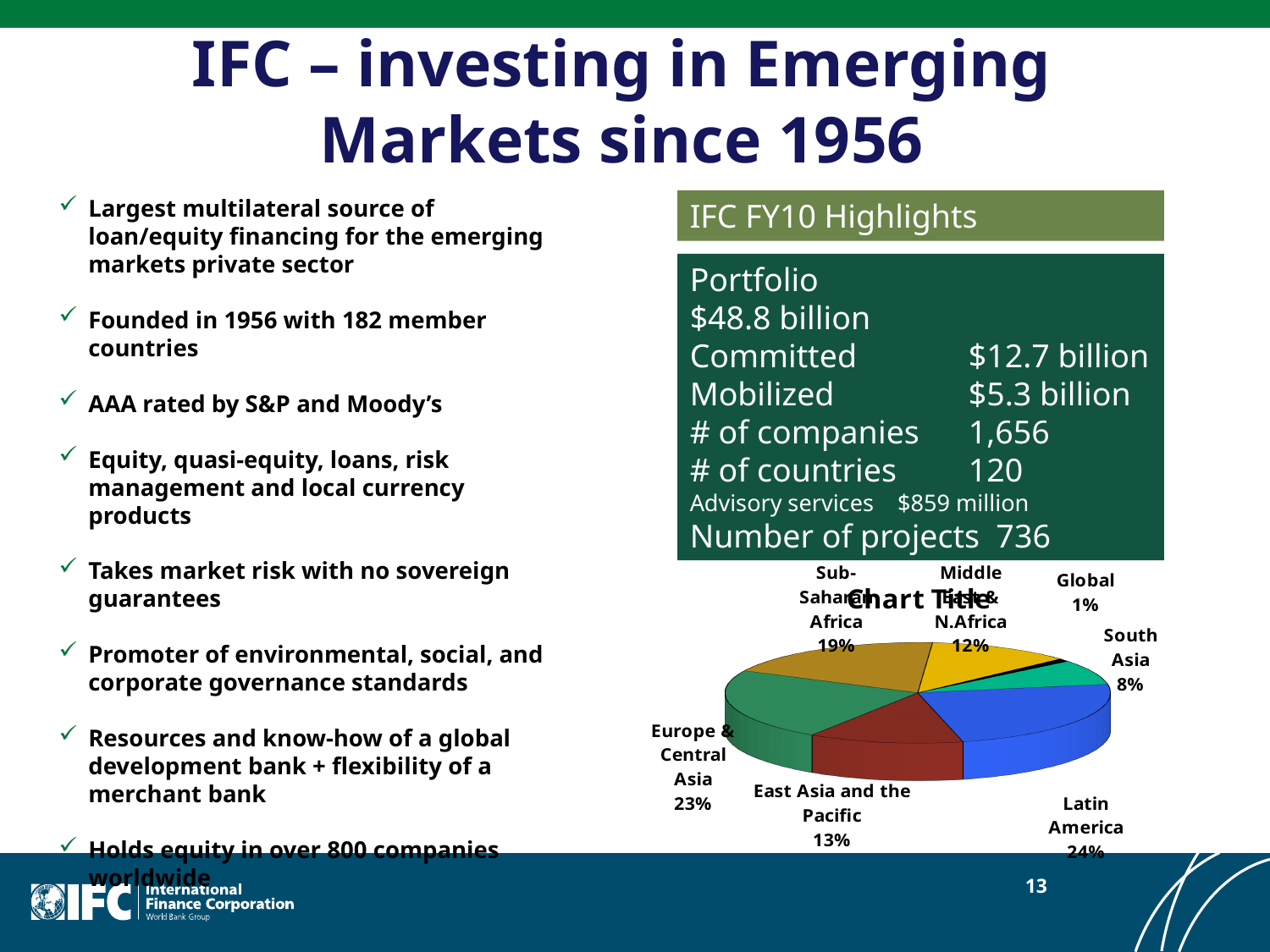
Which has a larger share in the pie chart, East Asia and the Pacific or Middle East & N.Africa? East Asia and the Pacific How many slices does the pie chart have? 7 What share of the pie chart does Middle East & N.Africa represent? 12% What is the title shown on the pie chart? Chart Title Which region has the largest share in the pie chart? Latin America What is the difference in percentage points between Sub-Saharan Africa and South Asia in the pie chart? 11 What type of chart is shown on the slide? pie chart What share of the pie chart does Sub-Saharan Africa represent? 19% Which category has the smallest share in the pie chart? Global What share of the pie chart does Latin America represent? 24% What share of the pie chart does Europe & Central Asia represent? 23% What share of the pie chart does East Asia and the Pacific represent? 13%